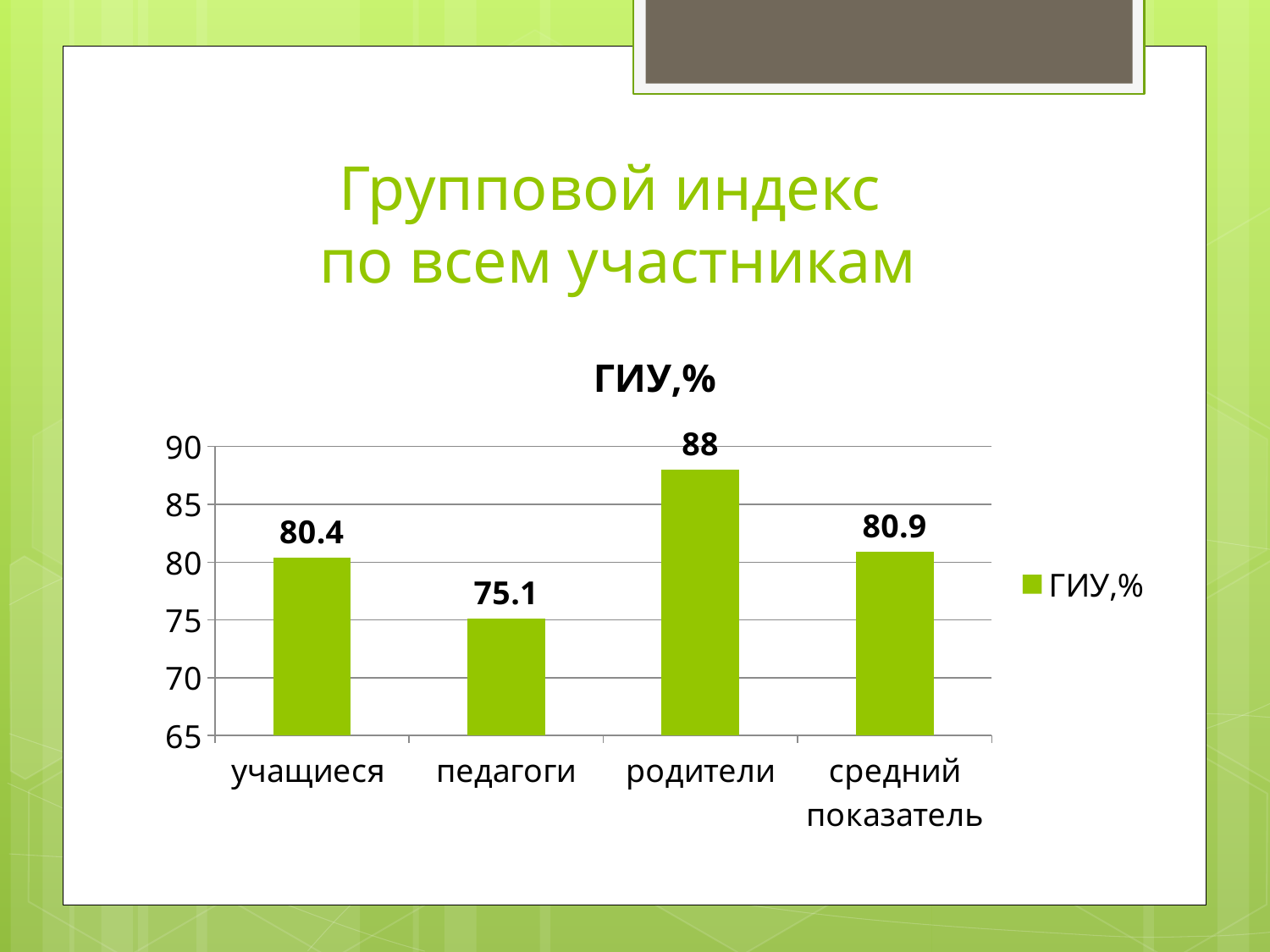
What is the value for средний показатель? 80.9 What is the value for учащиеся? 80.4 What is the value for педагоги? 75.1 How many series does the legend list? 1 What kind of chart is shown on the slide? bar chart What is the difference between the values for родители and педагоги? 12.9 Which category has the lowest value? педагоги What is the value for родители? 88 How many categories are shown on the x axis? 4 Is the value for родители greater or less than 85? greater Which category has the highest value? родители Which is larger, the value for учащиеся or the value for педагоги? учащиеся